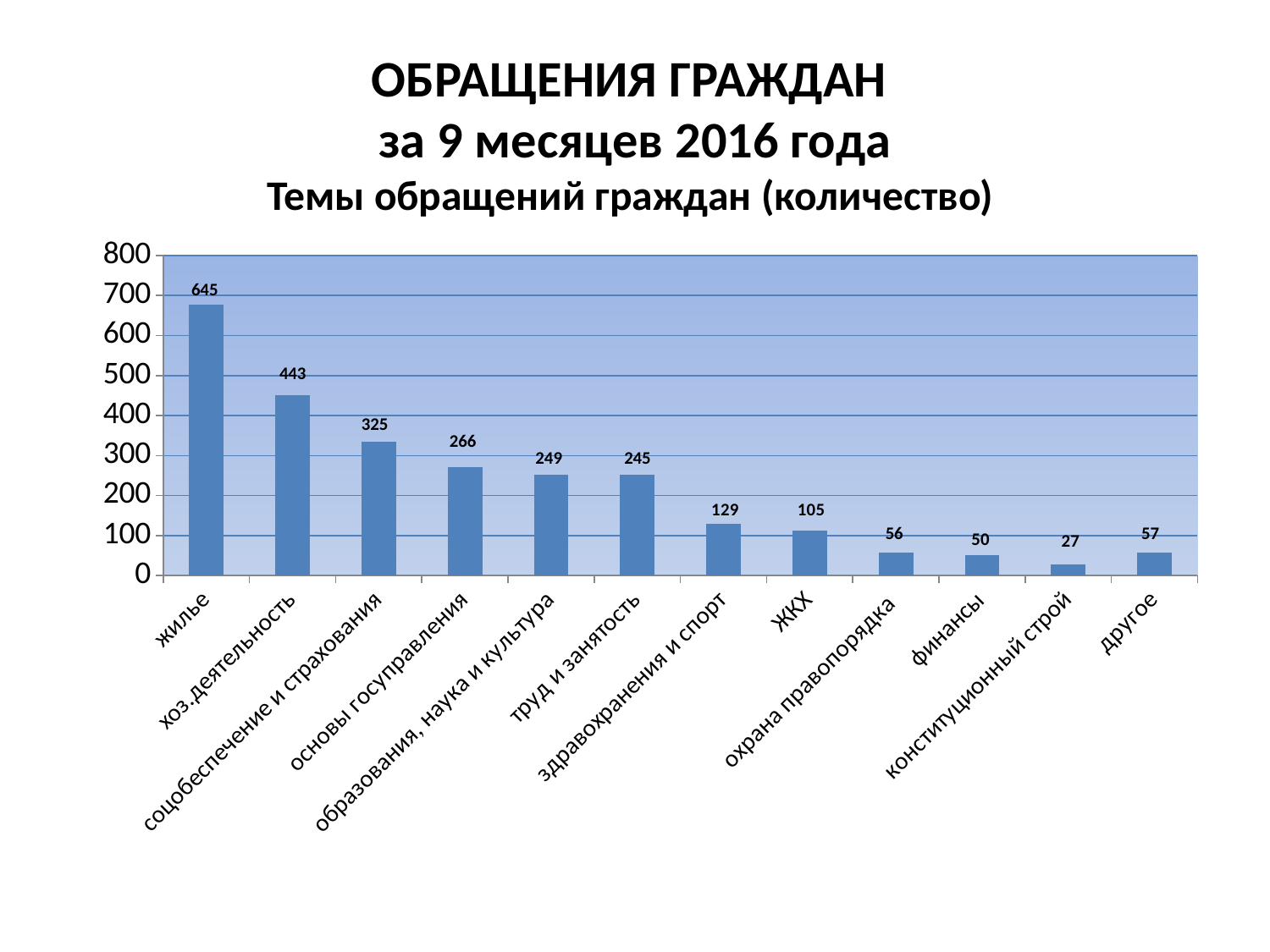
Which category has the highest value? жилье What is the title of the chart? Темы обращений граждан (количество) How many categories are shown on the x axis? 12 Is the value for здравоохранения и спорт greater or less than 200? less What is the value for жилье? 645 What is the difference between the values for жилье and хоз.деятельность? 202 What kind of chart is shown on the slide? bar chart Which category has the lowest value? конституционный строй Do the values generally rise or fall from left to right along the x axis? fall What is the value for конституционный строй? 27 Which is larger, the value for соцобеспечение и страхования or the value for основы госуправления? соцобеспечение и страхования What is the value for ЖКХ? 105